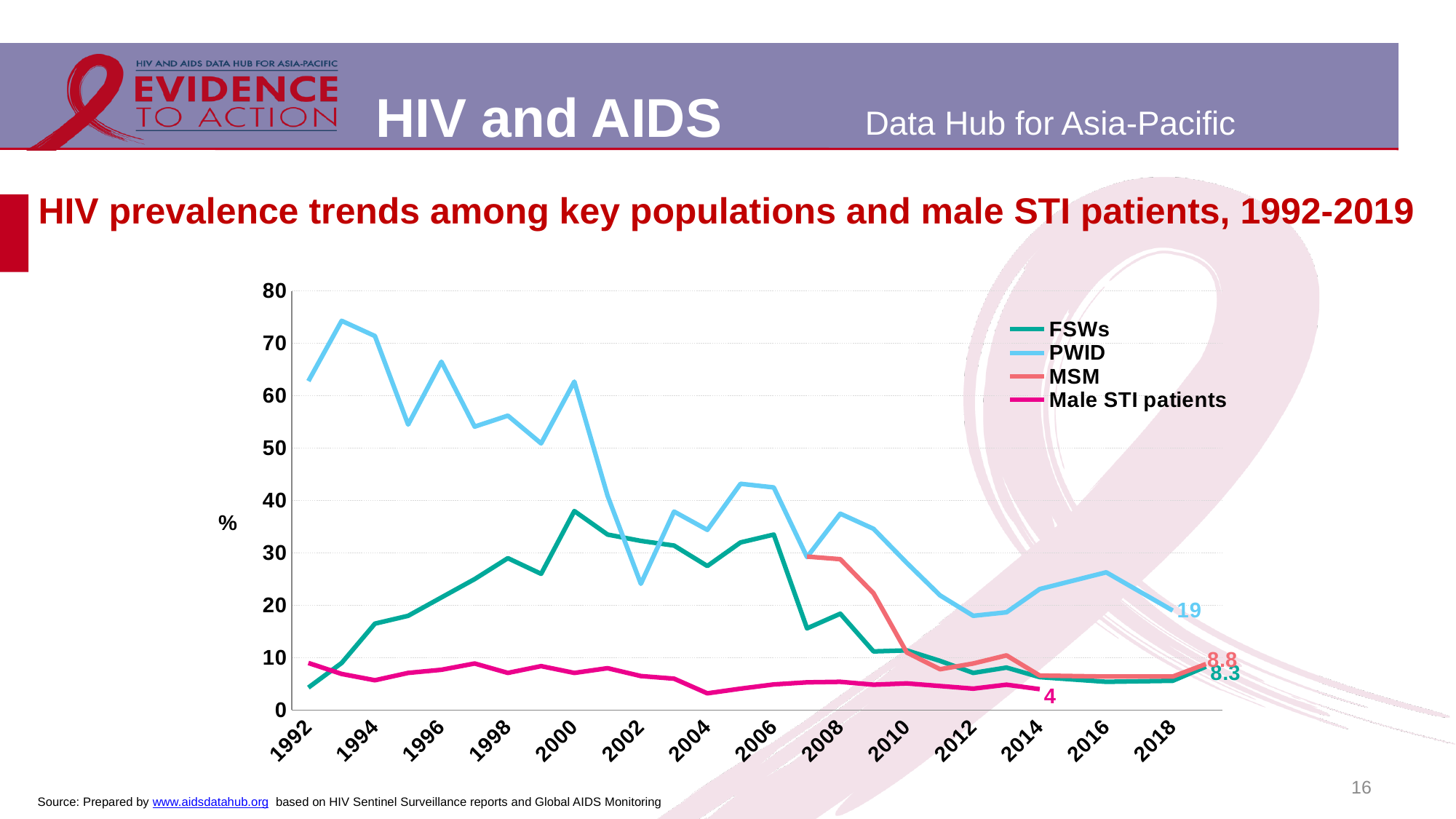
What is the labelled final value for FSWs? 8.3 What is the labelled final value for PWID? 19 What kind of chart is shown on the slide? line chart Which series has the highest labelled final value? PWID What is the difference between the labelled final values for MSM and FSWs? 0.5 What is the labelled final value for MSM? 8.8 What is the labelled last value for Male STI patients? 4 What is the difference between the labelled final values for PWID and MSM? 10.2 Is the value for PWID in 1992 greater or less than 50? greater What is the label on the y axis? % How many series does the legend list? 4 Does the PWID line overall rise or fall from 1992 to 2019? fall